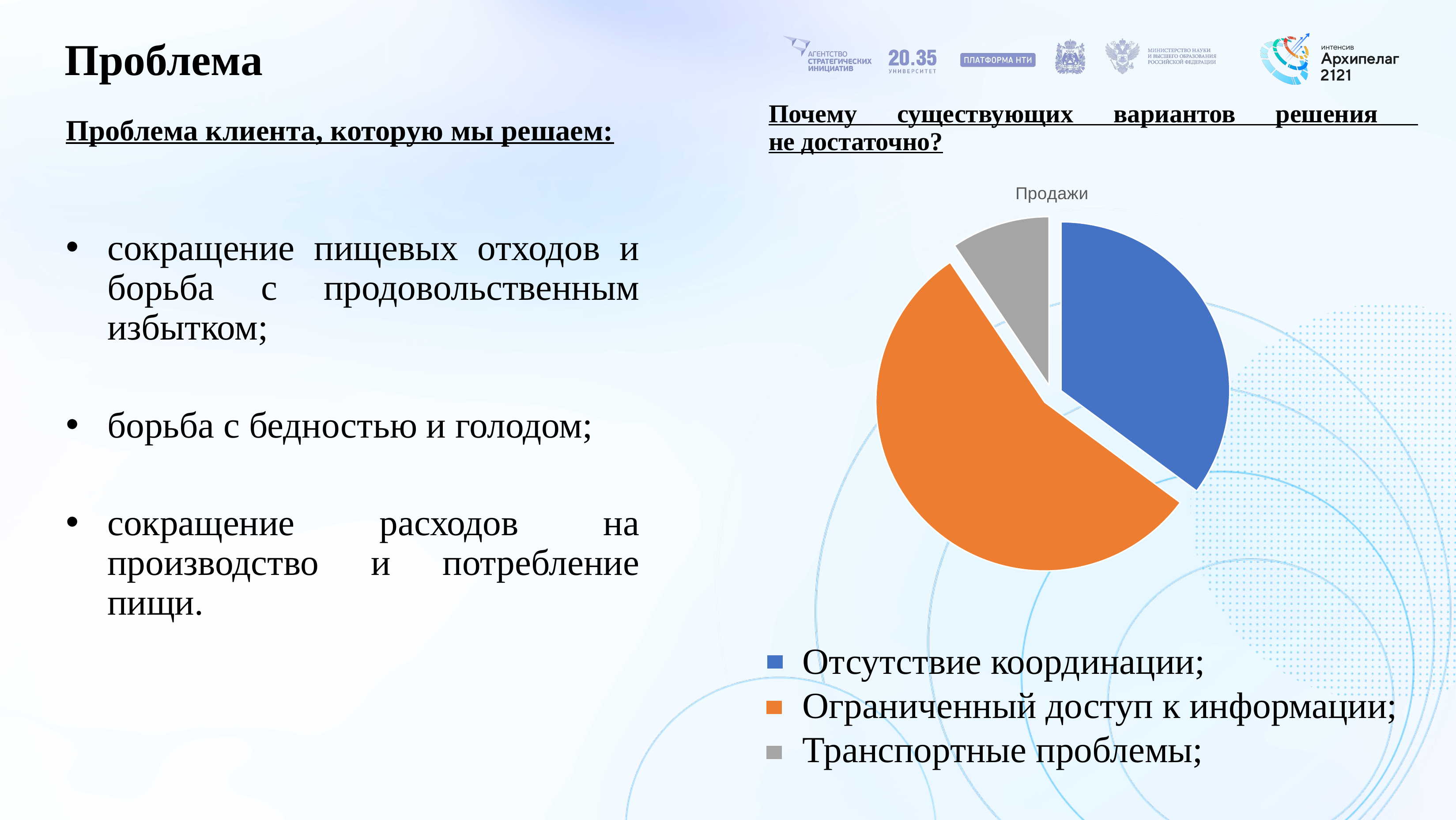
Which colour represents Транспортные проблемы in the pie chart? gray Which category has the smallest slice in the pie chart? Транспортные проблемы What kind of chart is shown on the slide? pie chart How many slices does the pie chart have? 3 Which slice is larger: Ограниченный доступ к информации or Отсутствие координации? Ограниченный доступ к информации Which category has the largest slice in the pie chart? Ограниченный доступ к информации How many entries does the legend of the pie chart list? 3 What is the title of the pie chart? Продажи Which slice is larger: Отсутствие координации or Транспортные проблемы? Отсутствие координации